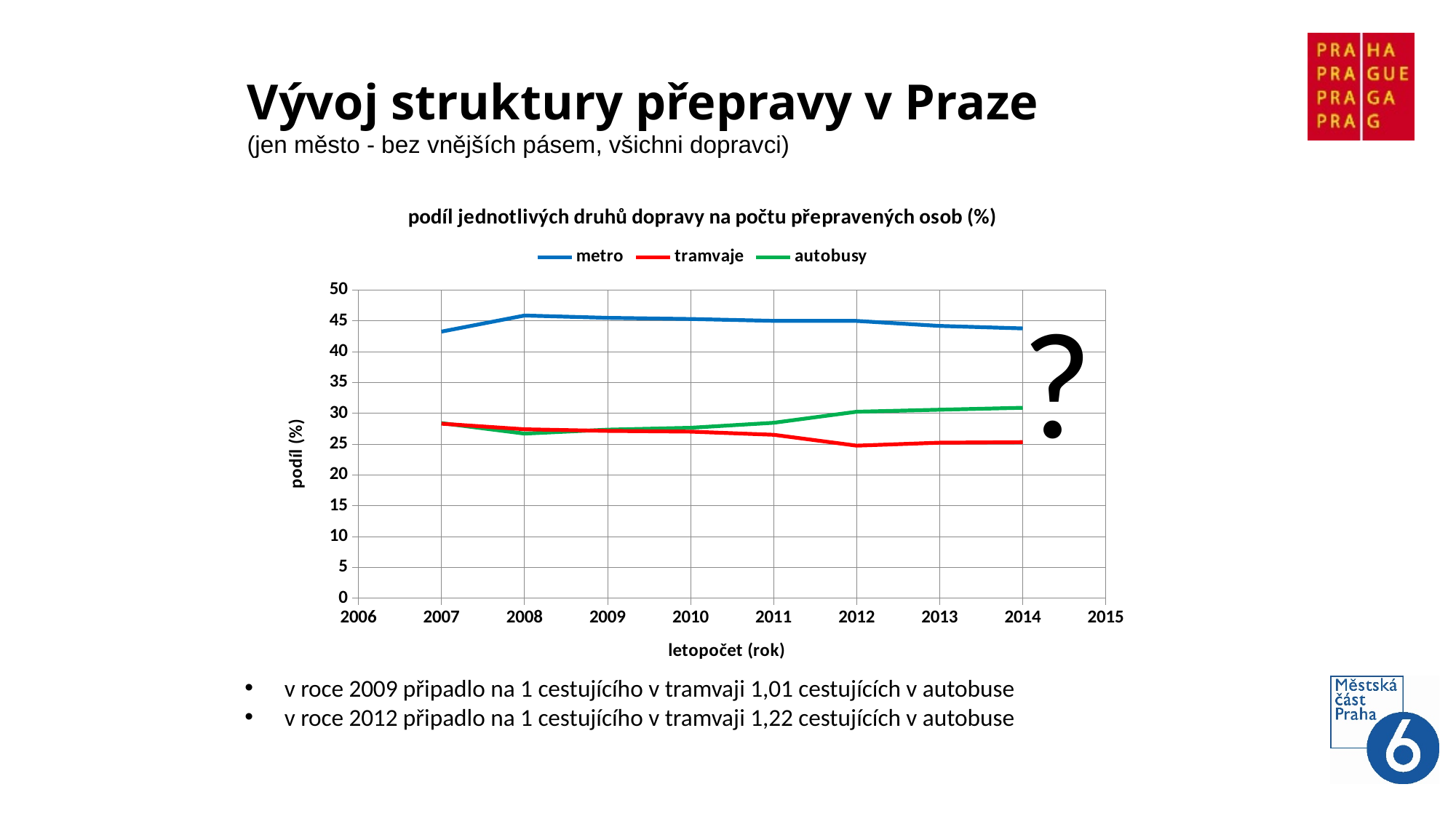
What are the three series named in the legend? metro, tramvaje, autobusy Is the value for tramvaje in 2012 greater or less than 30? less Which series has the lowest value in 2014? tramvaje Is the value for metro in 2008 greater or less than 40? greater What is the title of the chart? podíl jednotlivých druhů dopravy na počtu přepravených osob (%) Is the value for metro in 2014 greater or less than 45? less Which series has the highest value in 2012? metro Does the value for autobusy rise or fall between 2008 and 2014? rise What kind of chart is shown on the slide? line chart In 2014, which is larger: the value for autobusy or the value for tramvaje? autobusy How many series does the legend list? 3